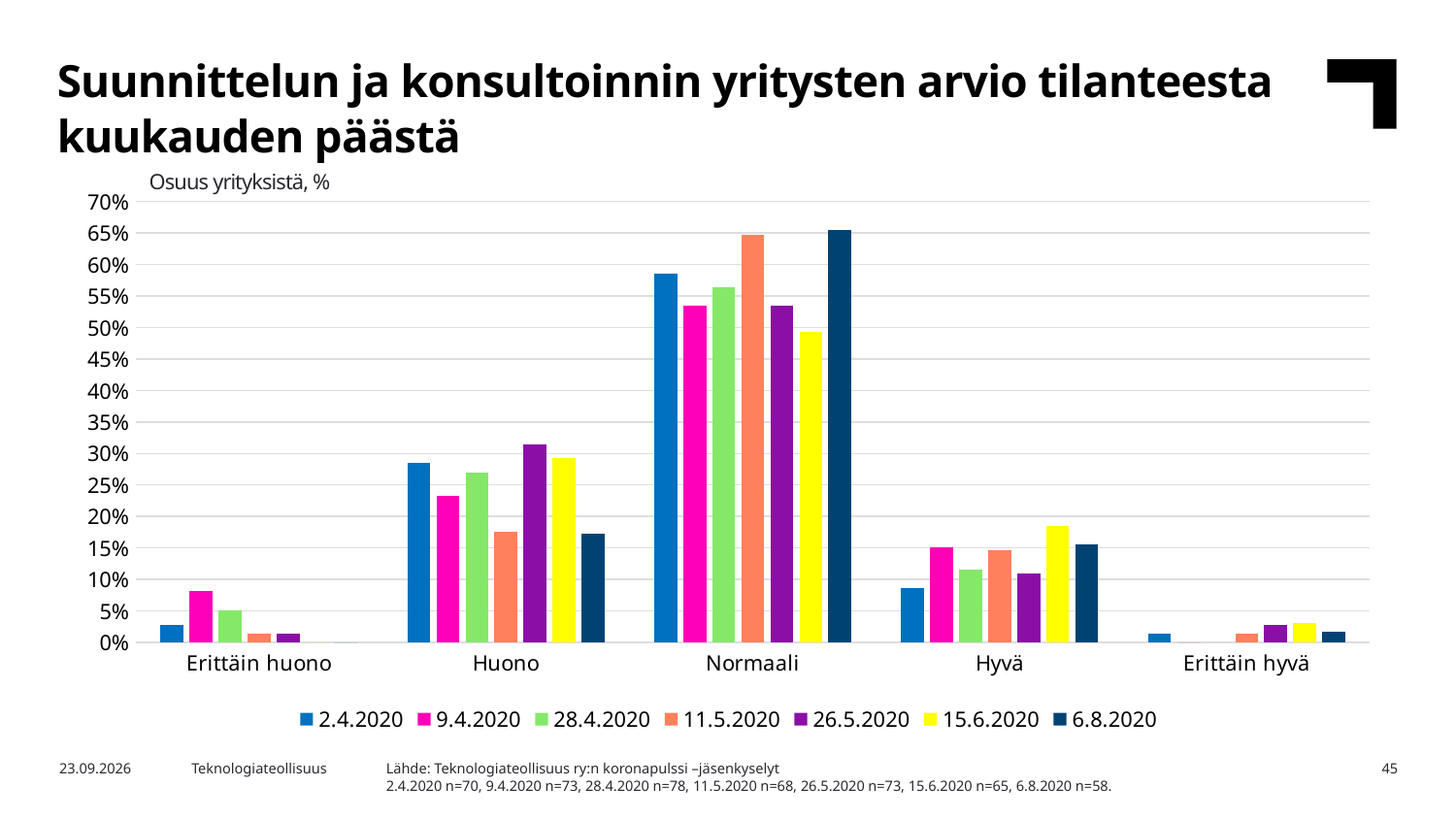
Within the Hyvä category, which series has the lowest value? 2.4.2020 Within the Erittäin huono category, which series has the highest value? 9.4.2020 How many series does the legend list? 7 How many categories are shown on the x axis? 5 In the Normaali category, which is larger: the value for 2.4.2020 or the value for 9.4.2020? 2.4.2020 What is the label of the y axis shown above the chart? Osuus yrityksistä, % Which category has the tallest bars overall? Normaali Within the Hyvä category, which series has the highest value? 15.6.2020 What kind of chart is shown on the slide? bar chart Is the value for 11.5.2020 in the Normaali category greater or less than 60%? greater